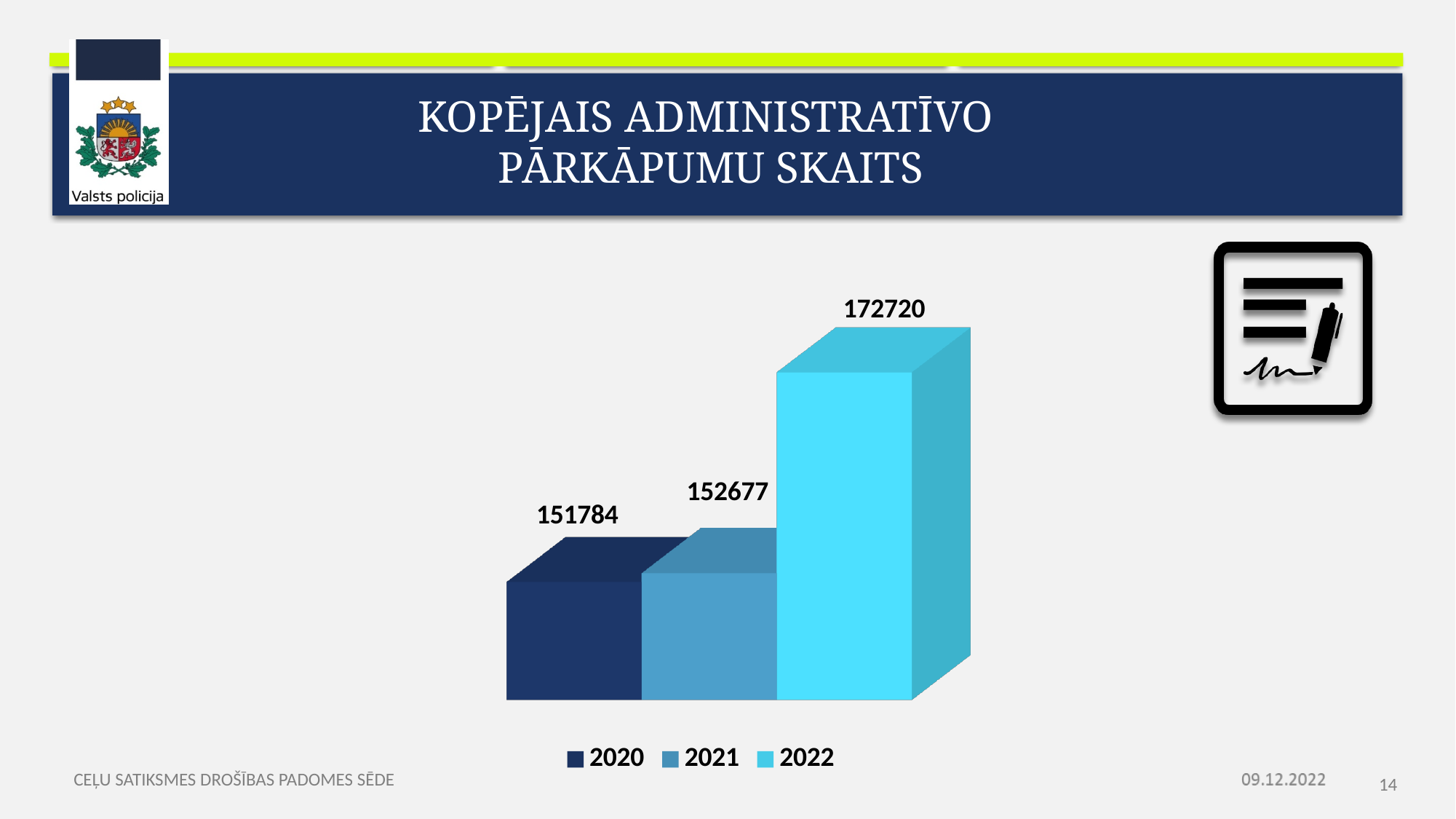
What is the difference between the values for 2022 and 2020? 20936 What is the difference between the values for 2022 and 2021? 20043 What is the value for 2021? 152677 Which year has the lowest value? 2020 How many bars are shown in the chart? 3 How many entries does the legend list? 3 What is the value for 2022? 172720 Which year has the highest value? 2022 What kind of chart is shown on the slide? bar chart What is the difference between the values for 2021 and 2020? 893 Which is larger, the value for 2022 or the value for 2020? 2022 What is the value for 2020? 151784